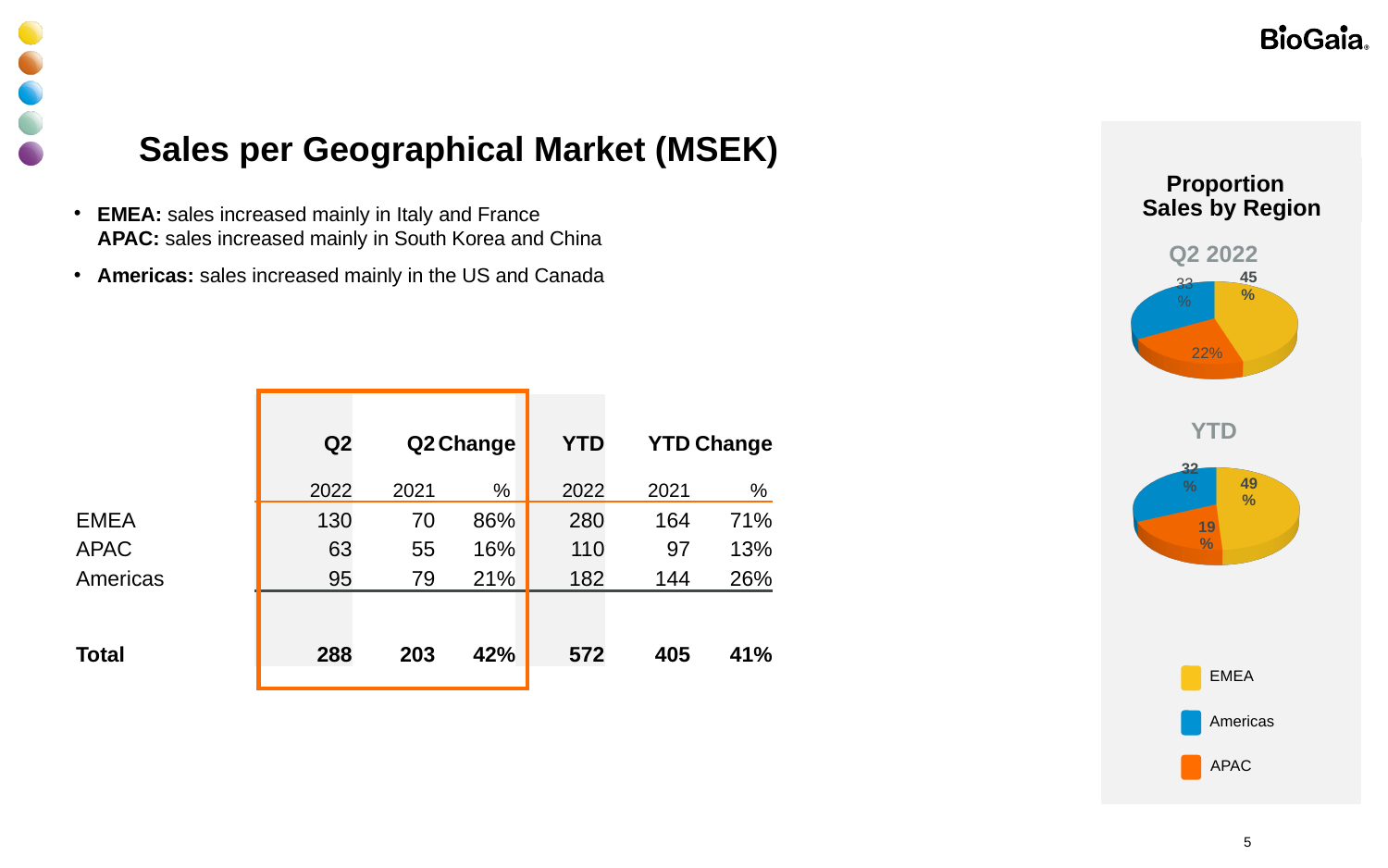
In the YTD pie chart, what share of sales does APAC account for? 19% In the YTD pie chart, what share of sales does EMEA account for? 49% In the Q2 2022 pie chart, what is the difference in percentage points between the EMEA share and the APAC share? 23 In the Q2 2022 pie chart, what share of sales does EMEA account for? 45% In the Proportion Sales by Region charts, which region is shown in yellow? EMEA In the Q2 2022 pie chart, what share of sales does APAC account for? 22% How many regions does the legend of the Proportion Sales by Region charts list? 3 In the Q2 2022 pie chart, which region has the largest share of sales? EMEA In the YTD pie chart, which is larger: the Americas share or the APAC share? Americas What type of chart is used to show Proportion Sales by Region for Q2 2022? Pie chart In the YTD pie chart, what share of sales does Americas account for? 32% In the YTD pie chart, which region has the smallest share of sales? APAC